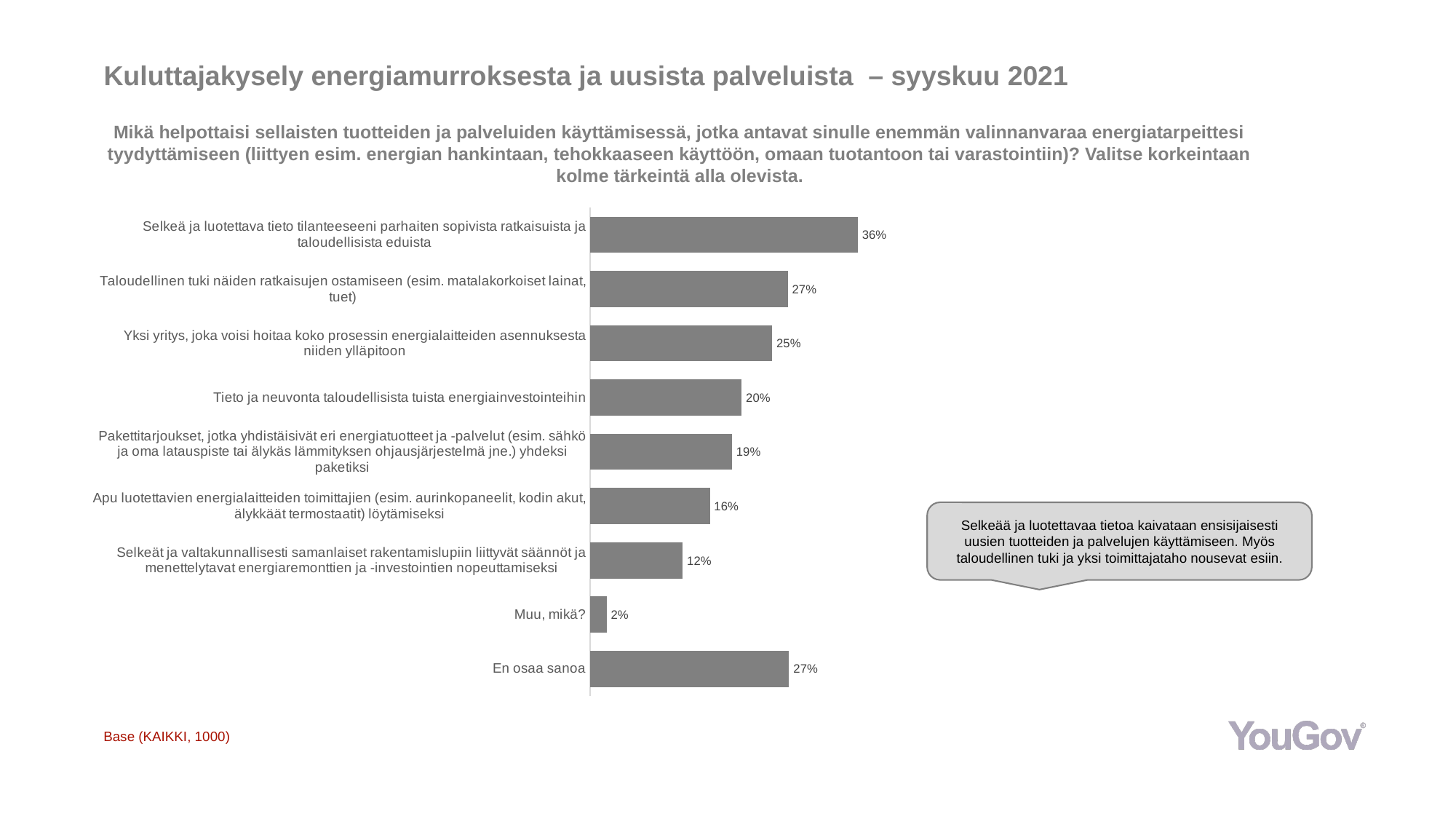
What percentage is shown for "Tieto ja neuvonta taloudellisista tuista energiainvestointeihin"? 20% What percentage is shown for "Apu luotettavien energialaitteiden toimittajien (esim. aurinkopaneelit, kodin akut, älykkäät termostaatit) löytämiseksi"? 16% What is the base size stated on the slide? Base (KAIKKI, 1000) What is the difference between the value for "Selkeä ja luotettava tieto tilanteeseeni parhaiten sopivista ratkaisuista ja taloudellisista eduista" and the value for "Taloudellinen tuki näiden ratkaisujen ostamiseen (esim. matalakorkoiset lainat, tuet)"? 9% What is the difference between the value for "Yksi yritys, joka voisi hoitaa koko prosessin energialaitteiden asennuksesta niiden ylläpitoon" and the value for "Selkeät ja valtakunnallisesti samanlaiset rakentamislupiin liittyvät säännöt ja menettelytavat energiaremonttien ja -investointien nopeuttamiseksi"? 13% What percentage is shown for "Muu, mikä?"? 2% Which is larger: the value for "Pakettitarjoukset, jotka yhdistäisivät eri energiatuotteet ja -palvelut (esim. sähkö ja oma latauspiste tai älykäs lämmityksen ohjausjärjestelmä jne.) yhdeksi paketiksi" or the value for "Selkeät ja valtakunnallisesti samanlaiset rakentamislupiin liittyvät säännöt ja menettelytavat energiaremonttien ja -investointien nopeuttamiseksi"? Pakettitarjoukset, jotka yhdistäisivät eri energiatuotteet ja -palvelut (esim. sähkö ja oma latauspiste tai älykäs lämmityksen ohjausjärjestelmä jne.) yhdeksi paketiksi What percentage is shown for "En osaa sanoa"? 27% Which category has the highest value? Selkeä ja luotettava tieto tilanteeseeni parhaiten sopivista ratkaisuista ja taloudellisista eduista How many categories are shown in the chart? 9 Which category has the lowest value? Muu, mikä? What kind of chart is shown on the slide? Bar chart